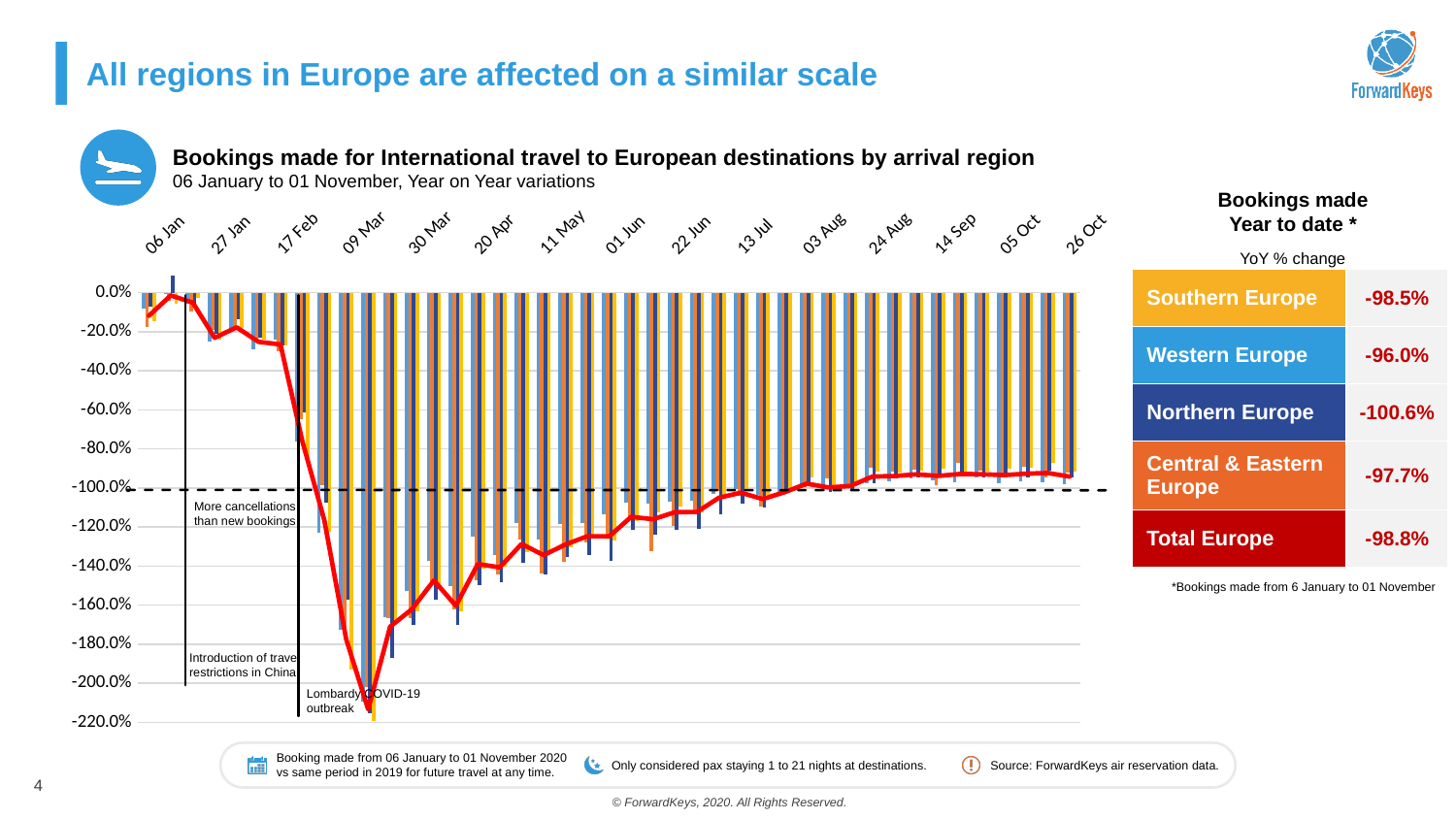
How many date labels are shown along the x axis of the chart? 15 In the 'Bookings made Year to date' table, what is the difference in percentage points between Western Europe (-96.0%) and Northern Europe (-100.6%)? 4.6 Is the value of the red line at 17 Feb greater or less than -40.0%? greater Is the value of the red line at 26 Oct greater or less than -100.0%? greater Is the value of the red line at 09 Mar greater or less than -200.0%? greater In the 'Bookings made Year to date' table, which region has the least negative YoY % change? Western Europe In the 'Bookings made Year to date' table, what is the YoY % change for Northern Europe? -100.6% What kind of chart is shown on the slide? combination bar and line chart Do the values of the red line rise or fall between 09 Mar and 26 Oct? rise What event is annotated on the chart near the 17 Feb to 09 Mar period? Lombardy COVID-19 outbreak In the 'Bookings made Year to date' table, what is the YoY % change for Southern Europe? -98.5%